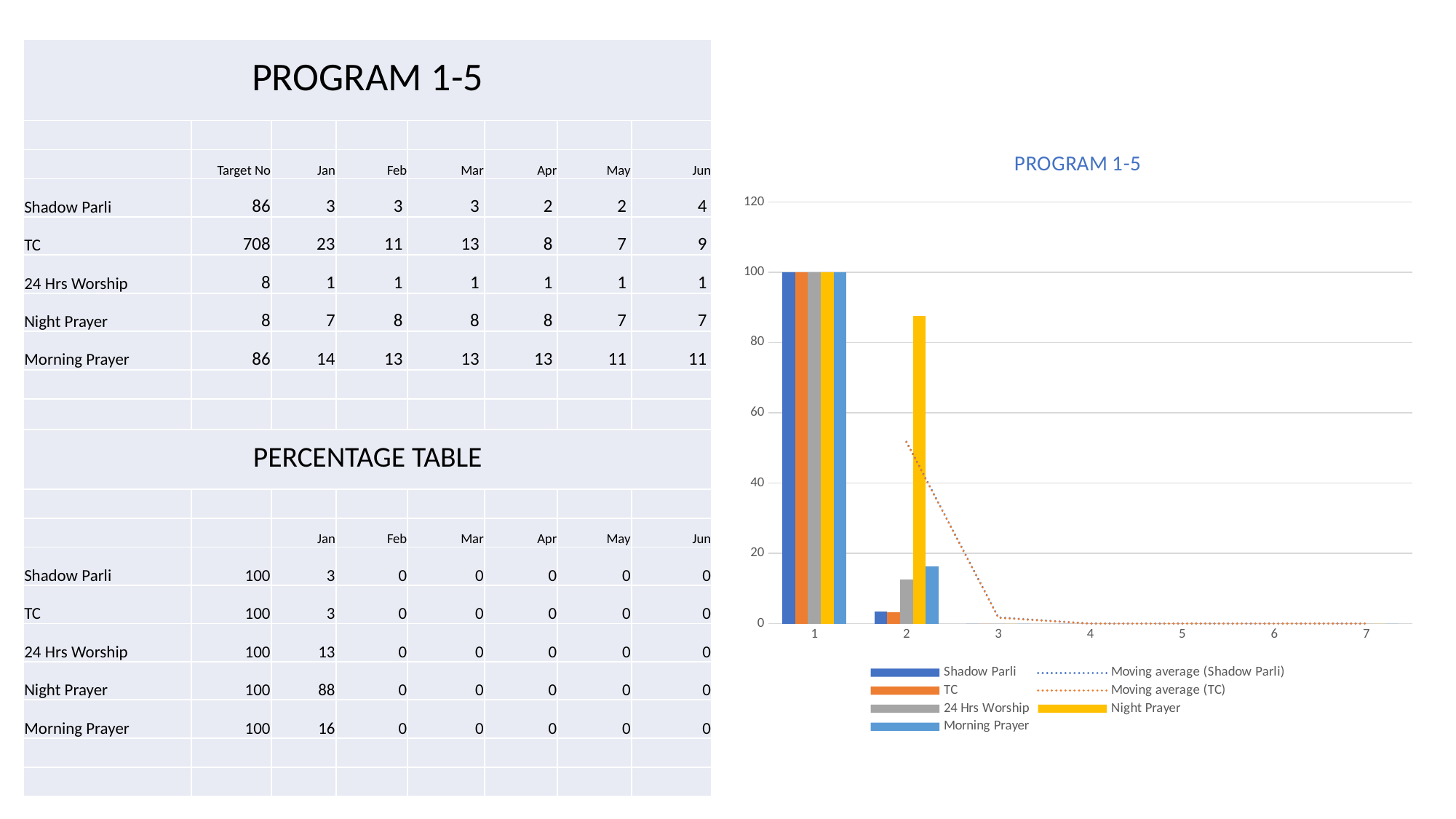
At category 2, which bar is taller: Night Prayer or Morning Prayer? Night Prayer How many categories are shown along the x axis of the chart? 7 Is the value of the Morning Prayer bar at category 2 greater or less than 20? less What kind of chart is shown on the slide? bar chart Is the value of the Night Prayer bar at category 2 greater or less than 80? greater What is the value of the Night Prayer bar at category 1? 100 Which series has the highest bar at category 2? Night Prayer What colour are the Night Prayer bars in the chart? yellow What is the value of the Shadow Parli bar at category 1? 100 Does the Moving average (TC) line rise or fall from category 2 to category 7? fall How many entries does the chart's legend list? 7 What is the title of the chart? PROGRAM 1-5